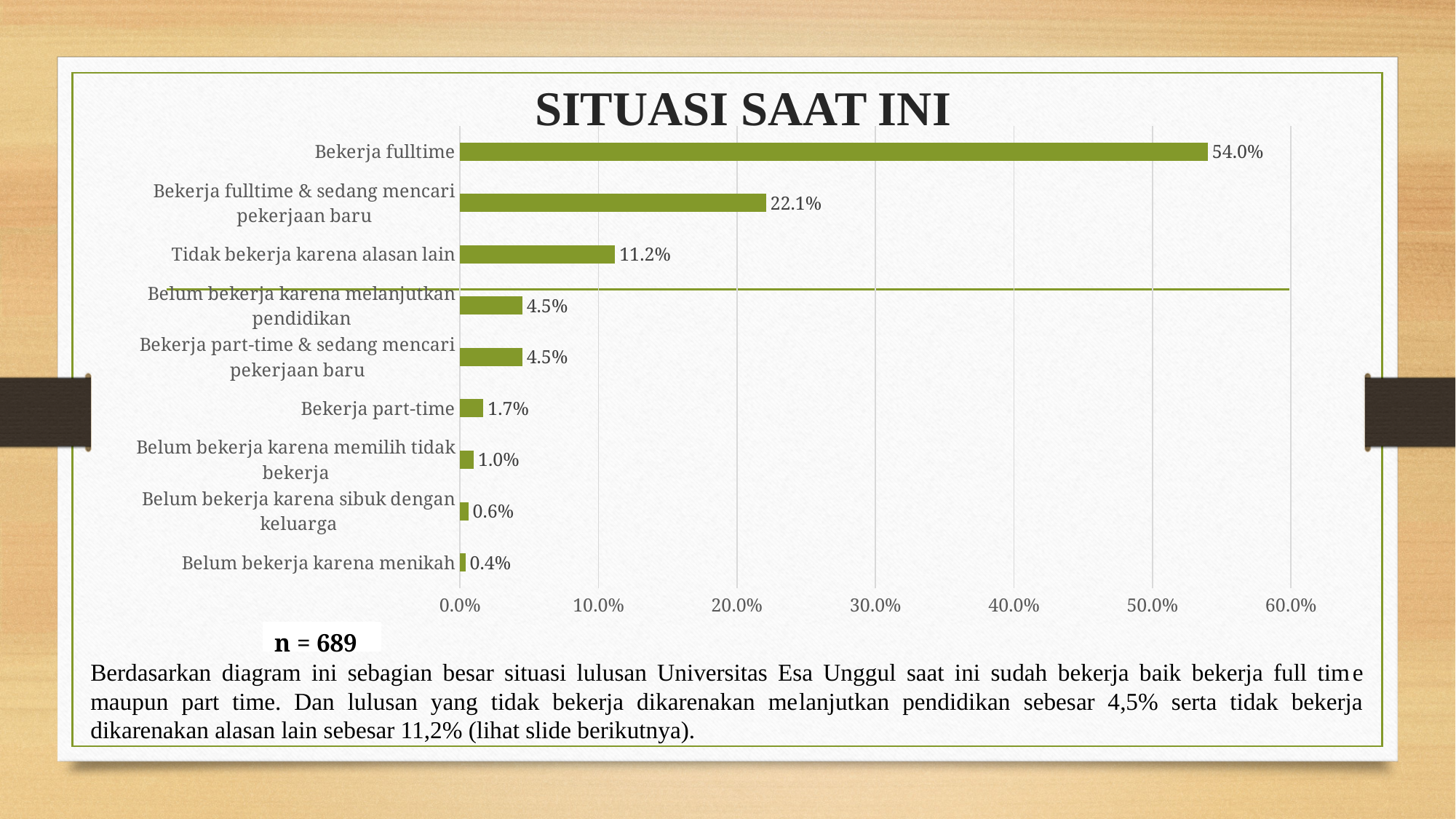
What is the value for Tidak bekerja karena alasan lain? 11.2% What is the value for Bekerja fulltime? 54.0% How many categories are shown in the chart? 9 Which category has the lowest value? Belum bekerja karena menikah Which category has the highest value? Bekerja fulltime Which is larger: Bekerja part-time or Belum bekerja karena memilih tidak bekerja? Bekerja part-time What is the title of the chart? SITUASI SAAT INI What is the value for Bekerja fulltime & sedang mencari pekerjaan baru? 22.1% What kind of chart is shown on the slide? bar chart Is the value for Bekerja fulltime greater or less than 50.0%? greater What is the value for Belum bekerja karena menikah? 0.4% What is the difference between Bekerja fulltime and Bekerja fulltime & sedang mencari pekerjaan baru? 31.9%